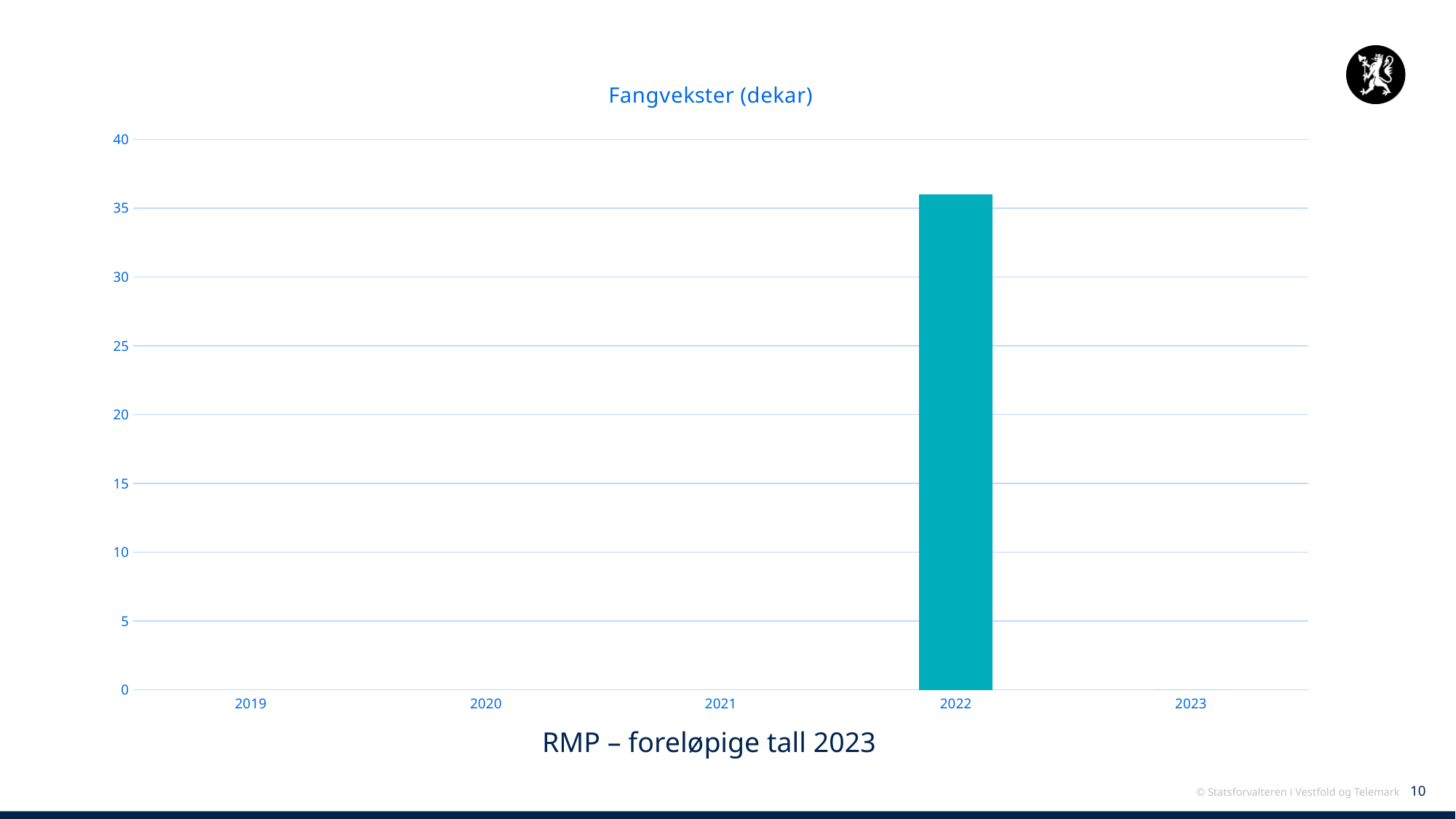
What is the title of the chart? Fangvekster (dekar) How many years show a visible bar in the chart? 1 What kind of chart is shown on the slide? bar chart What is the highest value shown on the y axis of the chart? 40 How many years are shown on the x axis of the chart? 5 Is the value for 2022 greater or less than 35? greater Which year has the highest value in the chart? 2022 Which year has a larger value, 2021 or 2022? 2022 What is the first year shown on the x axis? 2019 Is the value for 2022 greater or less than 40? less Which year has a larger value, 2022 or 2023? 2022 What is the last year shown on the x axis? 2023